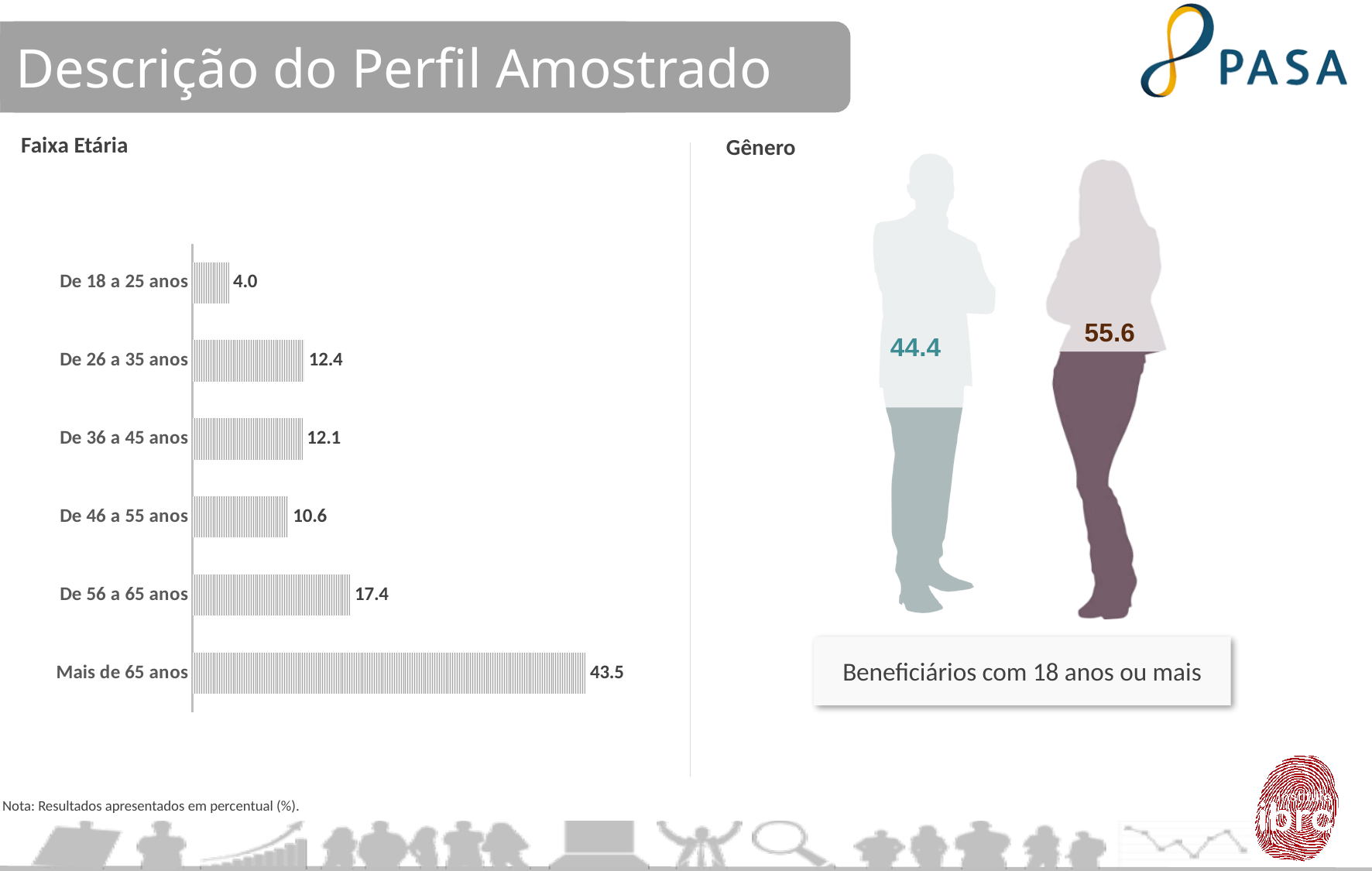
In the Gênero section, what is the value shown for the female figure? 55.6 In the Faixa Etária chart, what is the value for 'De 46 a 55 anos'? 10.6 In the Faixa Etária chart, which is larger: 'De 56 a 65 anos' or 'De 46 a 55 anos'? De 56 a 65 anos In the Faixa Etária chart, which age group has the highest value? Mais de 65 anos In the Faixa Etária chart, what is the difference between 'Mais de 65 anos' and 'De 56 a 65 anos'? 26.1 In the Faixa Etária chart, what is the value for 'Mais de 65 anos'? 43.5 How many age groups are shown in the Faixa Etária chart? 6 In the Faixa Etária chart, which age group has the lowest value? De 18 a 25 anos In the Faixa Etária chart, what is the value for 'De 18 a 25 anos'? 4.0 In the Faixa Etária chart, what is the value for 'De 56 a 65 anos'? 17.4 In the Faixa Etária chart, what is the difference between 'De 26 a 35 anos' and 'De 36 a 45 anos'? 0.3 What kind of chart is the Faixa Etária chart? Bar chart